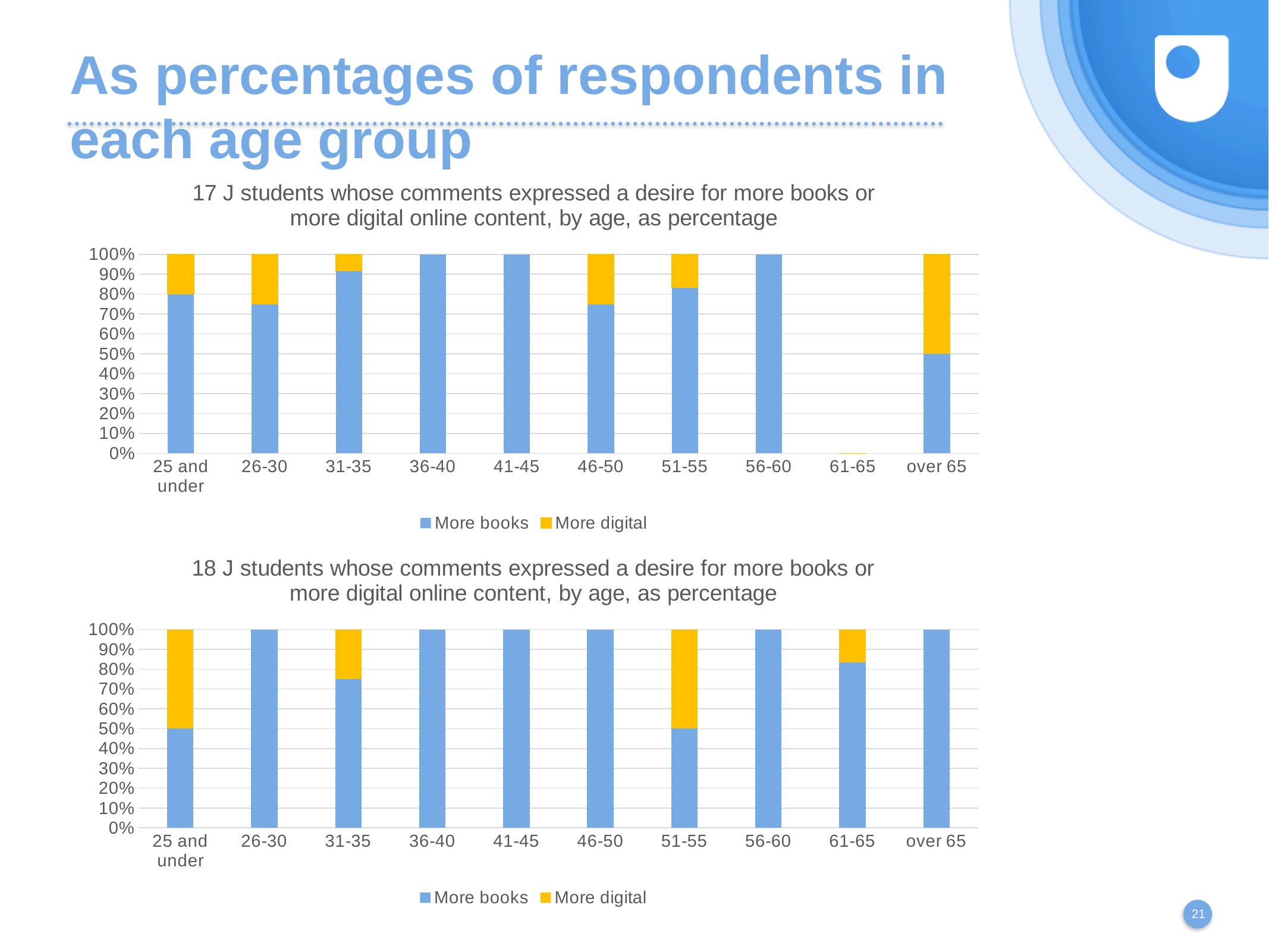
In the top chart (17 J), what percentage of respondents aged 25 and under wanted more books? 80% What kind of chart is the top chart (17 J)? Stacked bar chart How many age groups are shown on the x axis of the bottom chart (18 J)? 10 In the bottom chart (18 J), what percentage of respondents aged 51-55 wanted more books? 50% In the top chart (17 J), what percentage of respondents aged over 65 wanted more books? 50% In the top chart (17 J), what percentage of respondents aged 36-40 wanted more books? 100% In the top chart (17 J), is the More books value for the 26-30 age group greater or less than 80%? less In the bottom chart (18 J), what percentage of respondents aged 25 and under wanted more digital content? 50% How many series does the legend of the top chart (17 J) list? 2 In the bottom chart (18 J), is the More books value for the 31-35 age group greater or less than 80%? less In the top chart (17 J), which age group has the larger More books share: 25 and under or over 65? 25 and under In the bottom chart (18 J), which age group has the larger More digital share: 25 and under or 31-35? 25 and under